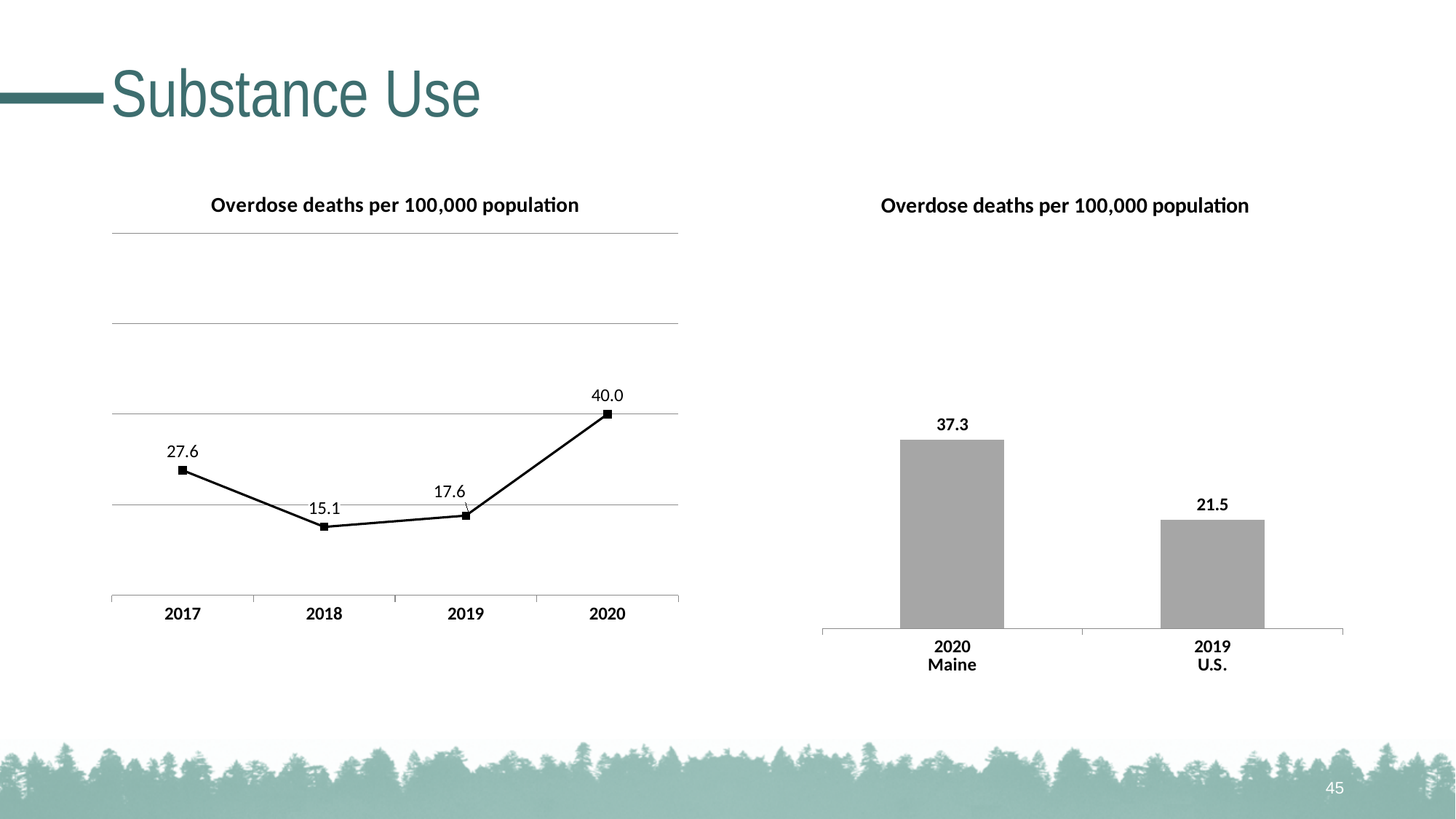
In the right chart, what is the difference between the 2020 Maine and 2019 U.S. values? 15.8 In the left chart, what kind of chart is shown? line chart In the left chart, which year has the highest value? 2020 In the right chart, which is larger, 2020 Maine or 2019 U.S.? 2020 Maine In the right chart, what is the value for 2019 U.S.? 21.5 In the left chart, do the values rise or fall from 2019 to 2020? rise In the left chart, how many years are plotted? 4 In the left chart, what is the value for 2017? 27.6 In the left chart, what is the difference between the 2020 and 2019 values? 22.4 In the left chart, what is the value for 2020? 40.0 In the right chart, what kind of chart is shown? bar chart In the left chart, which year has the lowest value? 2018